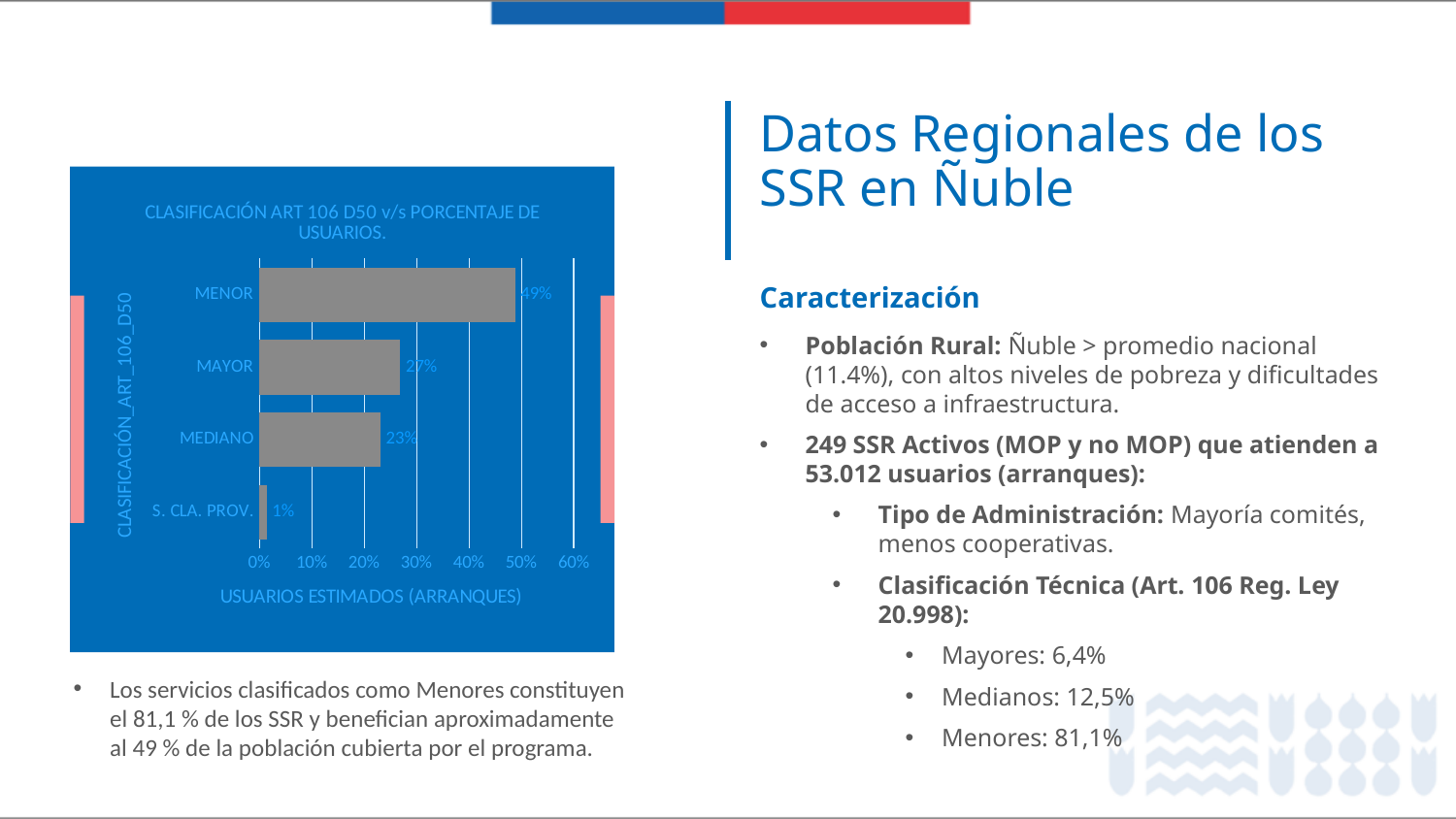
Which category has the lowest value in the chart? S. CLA. PROV. What is the value for MEDIANO in the chart? 23% Is the value for MAYOR greater or less than 20%? greater What is the value for MENOR in the chart? 49% What type of chart is shown on the slide? Bar chart Which has a larger value, MEDIANO or S. CLA. PROV.? MEDIANO What is the difference between the values for MENOR and MEDIANO? 26 percentage points What is the value for S. CLA. PROV. in the chart? 1% What is the label of the horizontal axis of the chart? USUARIOS ESTIMADOS (ARRANQUES) How many categories are shown in the chart? 4 What is the title of the chart? CLASIFICACIÓN ART 106 D50 v/s PORCENTAJE DE USUARIOS. Which category has the highest value in the chart? MENOR